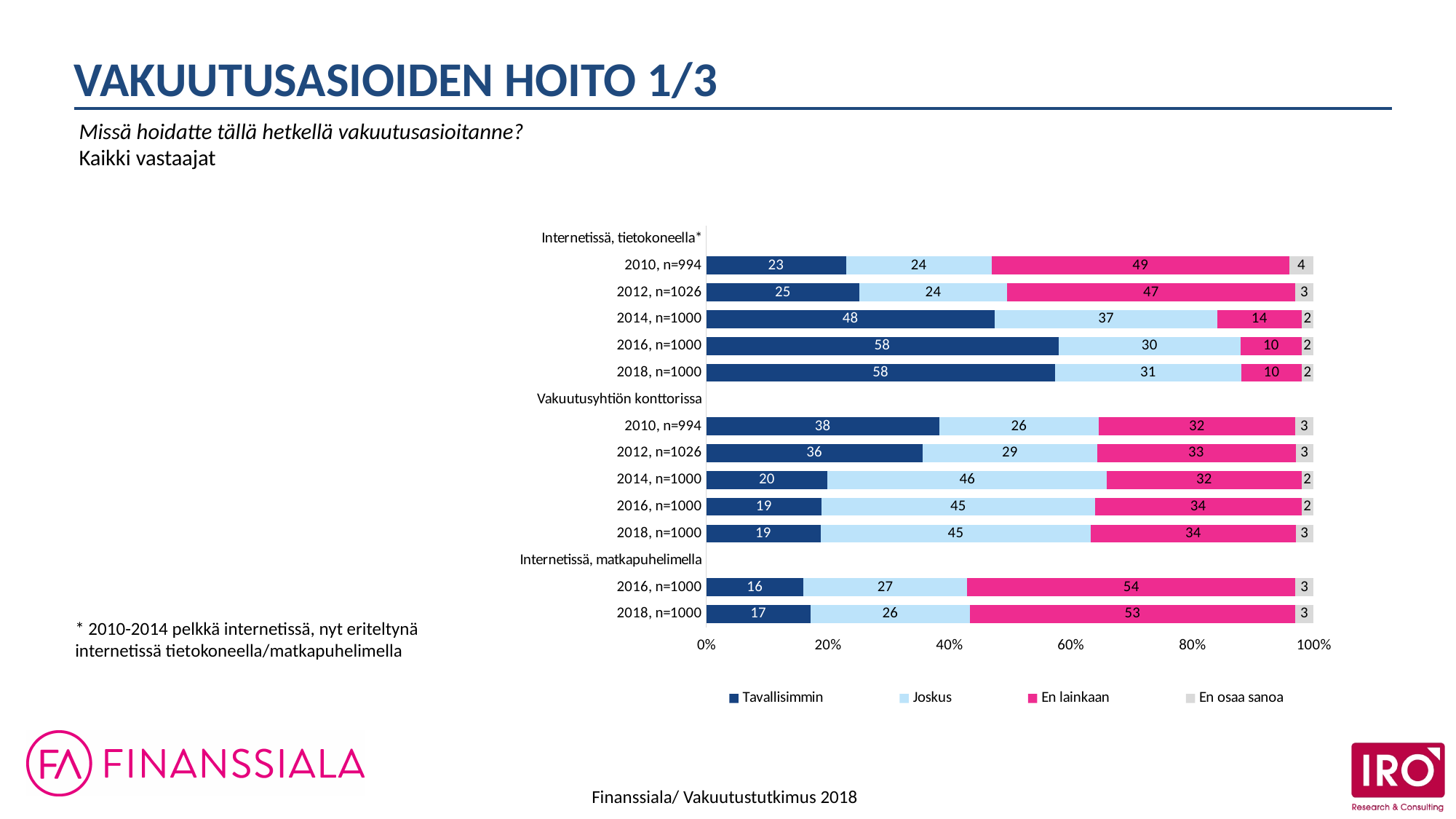
How many series does the legend list? 4 What is the 'Tavallisimmin' value for 'Internetissä, tietokoneella*' in 2018, n=1000? 58 Which year row under 'Internetissä, tietokoneella*' has the highest 'En lainkaan' value? 2010, n=994 What is the 'Joskus' value for 'Vakuutusyhtiön konttorissa' in 2014, n=1000? 46 What type of chart is shown on the slide? Stacked bar chart How many bars (year rows) are plotted in the chart? 12 What is the difference between the 'Tavallisimmin' values for 'Internetissä, tietokoneella*' in 2010, n=994 and 2014, n=1000? 25 Which is larger: the 'En lainkaan' value for 'Vakuutusyhtiön konttorissa' in 2018, n=1000 or the 'En lainkaan' value for 'Internetissä, tietokoneella*' in 2018, n=1000? Vakuutusyhtiön konttorissa 2018, n=1000 What is the 'En lainkaan' value for 'Internetissä, matkapuhelimella' in 2016, n=1000? 54 How does the 'Tavallisimmin' value for 'Internetissä, tietokoneella*' change from 2010, n=994 to 2018, n=1000? It rises Which year row under 'Vakuutusyhtiön konttorissa' has the lowest 'Tavallisimmin' value? 2016, n=1000 and 2018, n=1000 (both 19) What is the total of the 'Tavallisimmin' and 'Joskus' values for 'Internetissä, matkapuhelimella' in 2018, n=1000? 43